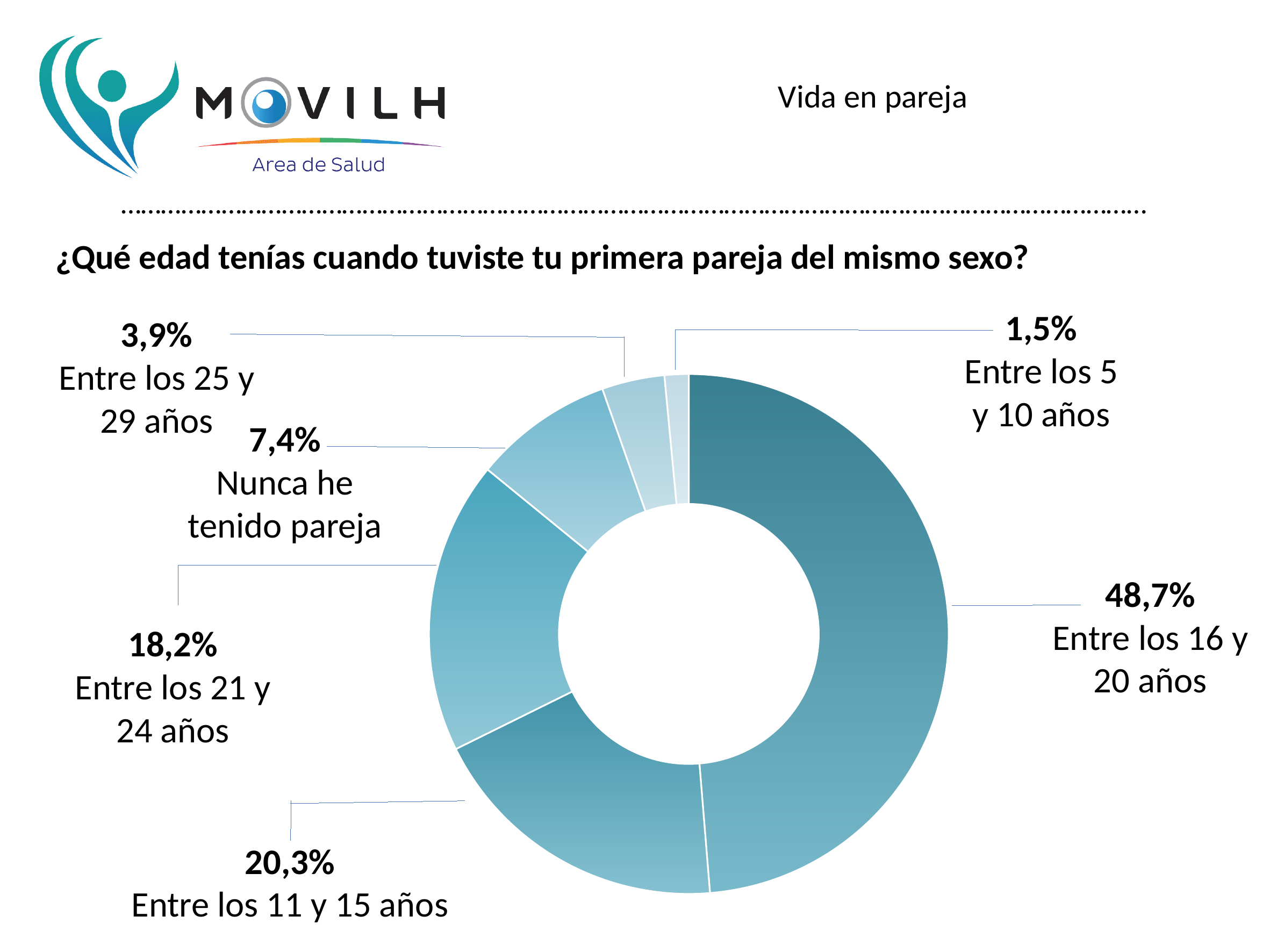
What percentage of respondents answered 'Entre los 5 y 10 años'? 1,5% Which category has the smallest share of the chart? Entre los 5 y 10 años Which category has the largest share of the chart? Entre los 16 y 20 años What is the difference in percentage points between 'Entre los 11 y 15 años' and 'Entre los 21 y 24 años'? 2,1 What is the combined share of 'Entre los 16 y 20 años' and 'Entre los 11 y 15 años'? 69,0% What kind of chart is shown on the slide? Doughnut chart What percentage of respondents answered 'Entre los 11 y 15 años'? 20,3% How many categories are shown in the chart? 6 What percentage of respondents answered 'Nunca he tenido pareja'? 7,4% What percentage of respondents answered 'Entre los 16 y 20 años'? 48,7% What question does the chart on the slide answer? ¿Qué edad tenías cuando tuviste tu primera pareja del mismo sexo? Which is larger: the share for 'Nunca he tenido pareja' or the share for 'Entre los 25 y 29 años'? Nunca he tenido pareja